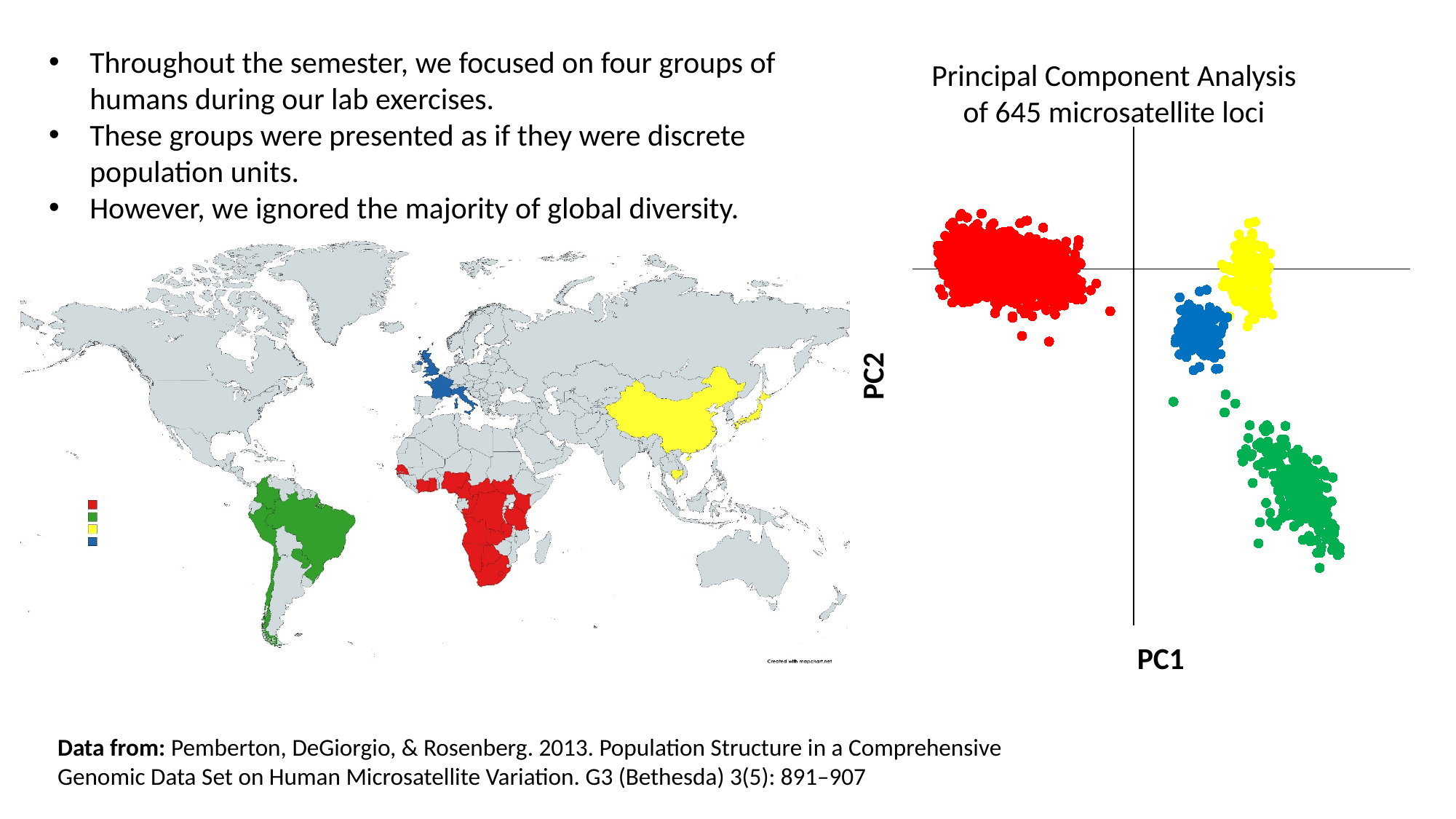
In the Principal Component Analysis plot, which coloured cluster lies furthest to the left along PC1? red How many distinct coloured clusters of points are shown in the Principal Component Analysis plot? 4 In the Principal Component Analysis plot, which coloured cluster has the lowest PC2 values? green What is the label of the horizontal axis of the Principal Component Analysis plot? PC1 In the Principal Component Analysis plot, which cluster has lower PC2 values, the green cluster or the red cluster? green In the Principal Component Analysis plot, which coloured cluster extends furthest to the right along PC1? green In the Principal Component Analysis plot, does the blue cluster lie above or below the horizontal axis line? below What is the title of the scatter plot on the right of the slide? Principal Component Analysis of 645 microsatellite loci In the Principal Component Analysis plot, how many coloured clusters lie to the right of the vertical axis line? 3 In the Principal Component Analysis plot, which cluster has higher PC2 values, the blue cluster or the yellow cluster? yellow What kind of chart is the Principal Component Analysis plot on the right of the slide? scatter chart